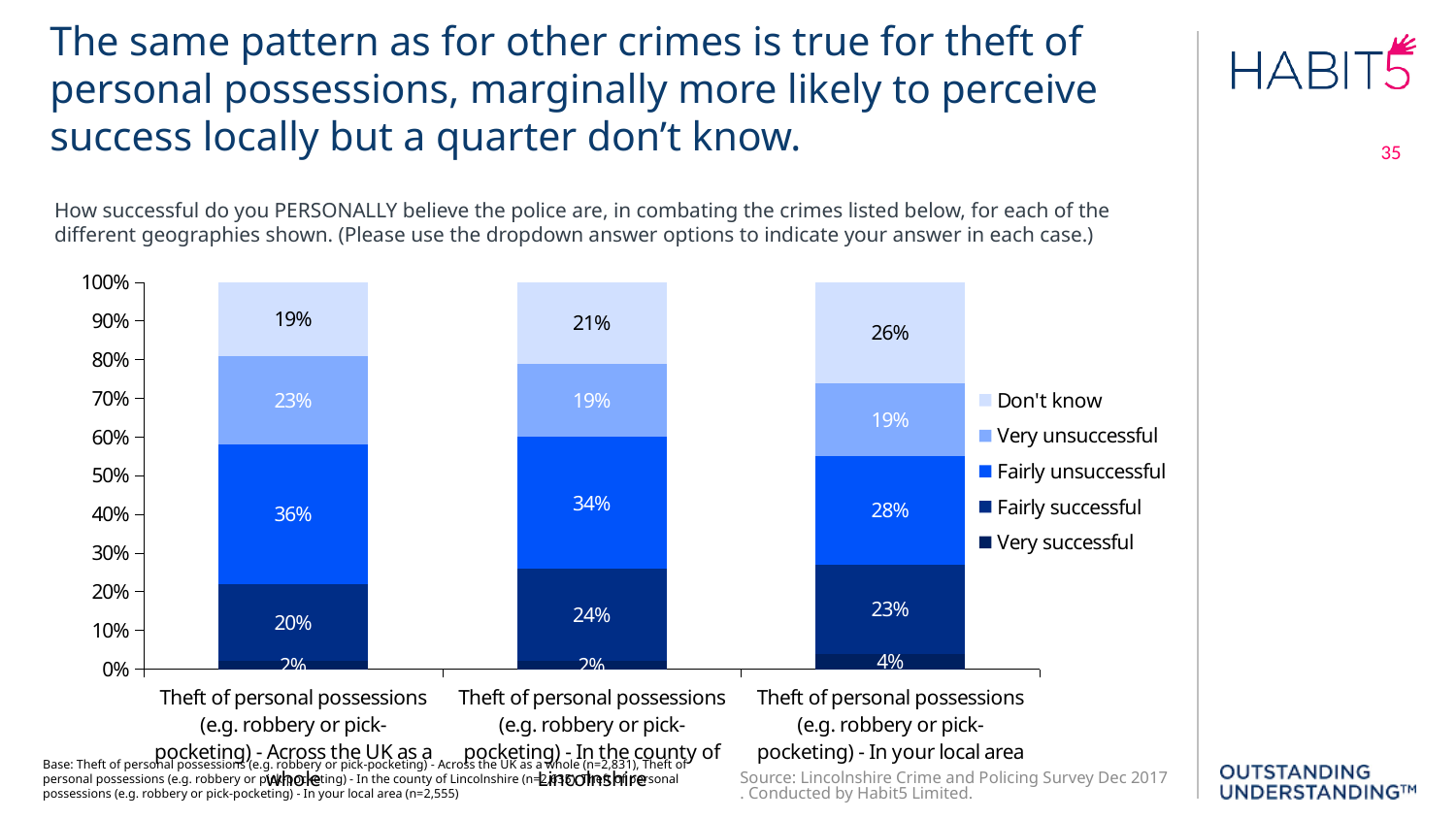
What is the 'Very successful' value for theft of personal possessions in your local area? 4% How many series does the legend list? 5 Which series is shown in the lightest blue colour in the legend? Don't know Which geography has the highest 'Don't know' share? In your local area Is the 'Fairly successful' value larger for across the UK as a whole or for in your local area? In your local area What is the 'Fairly unsuccessful' value for theft of personal possessions across the UK as a whole? 36% What is the difference between the 'Fairly unsuccessful' values for across the UK as a whole and in your local area? 8 percentage points Which geography has the lowest 'Fairly unsuccessful' share? In your local area What is the 'Don't know' value for theft of personal possessions in your local area? 26% What kind of chart is shown on the slide? Stacked bar chart How many categories (bars) are plotted on the chart? 3 What is the 'Fairly successful' value for theft of personal possessions in the county of Lincolnshire? 24%